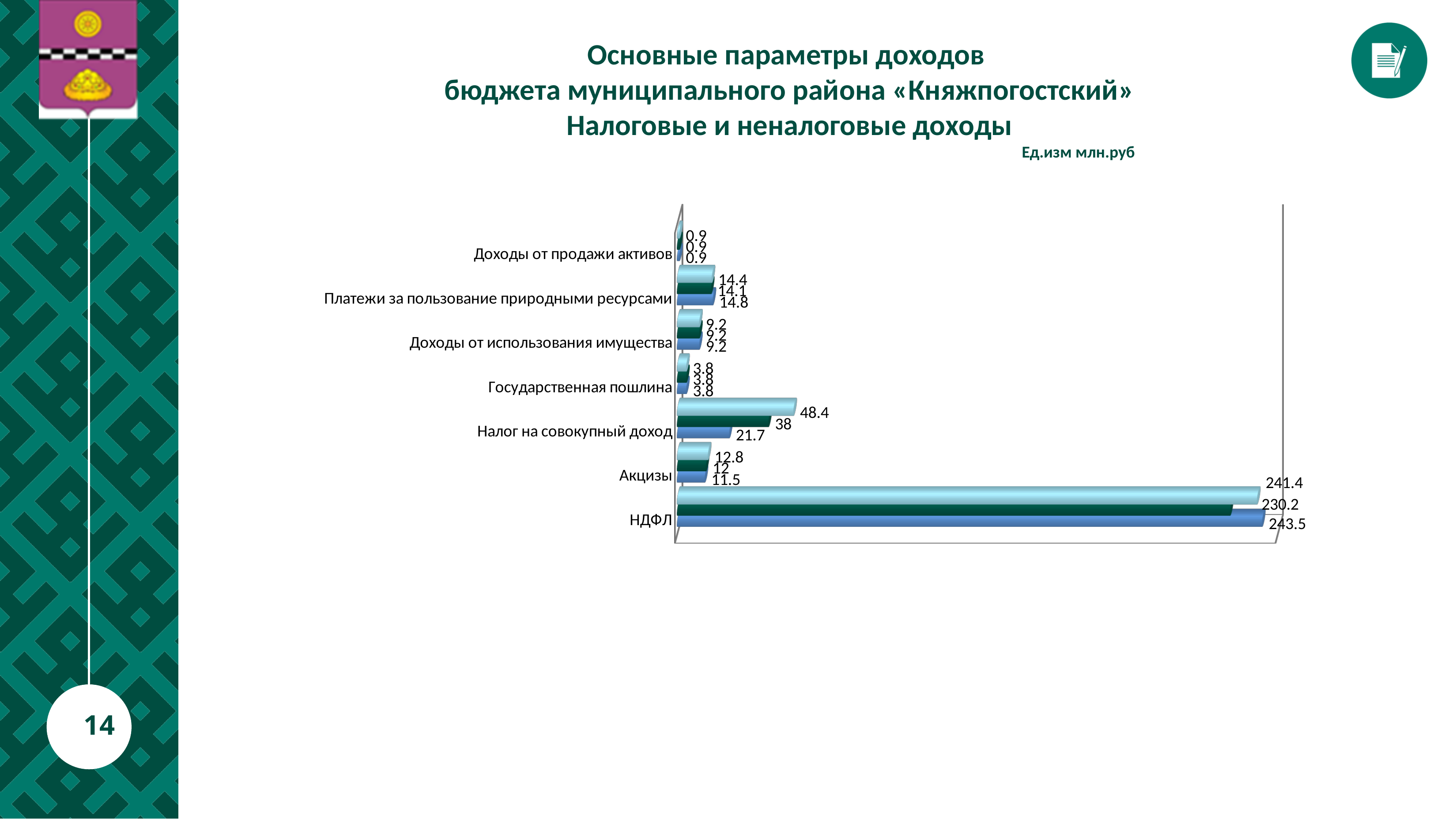
What is the difference between the light blue (top) bar and the blue (bottom) bar for Налог на совокупный доход? 26.7 What unit of measurement is stated on the slide for the chart values? млн.руб What is the value of the blue (bottom) bar for Платежи за пользование природными ресурсами? 14.8 Which category has the lowest values on the chart? Доходы от продажи активов What is the value of the dark green (middle) bar for Акцизы? 12 What is the value of the light blue (top) bar for Налог на совокупный доход? 48.4 How many categories are shown on the chart? 7 What is the value of the blue (bottom) bar for НДФЛ? 243.5 What is the value of each of the three bars for Государственная пошлина? 3.8 Which category has the highest values on the chart? НДФЛ What kind of chart is shown on the slide? bar chart For НДФЛ, which is larger: the light blue (top) bar or the dark green (middle) bar? the light blue (top) bar